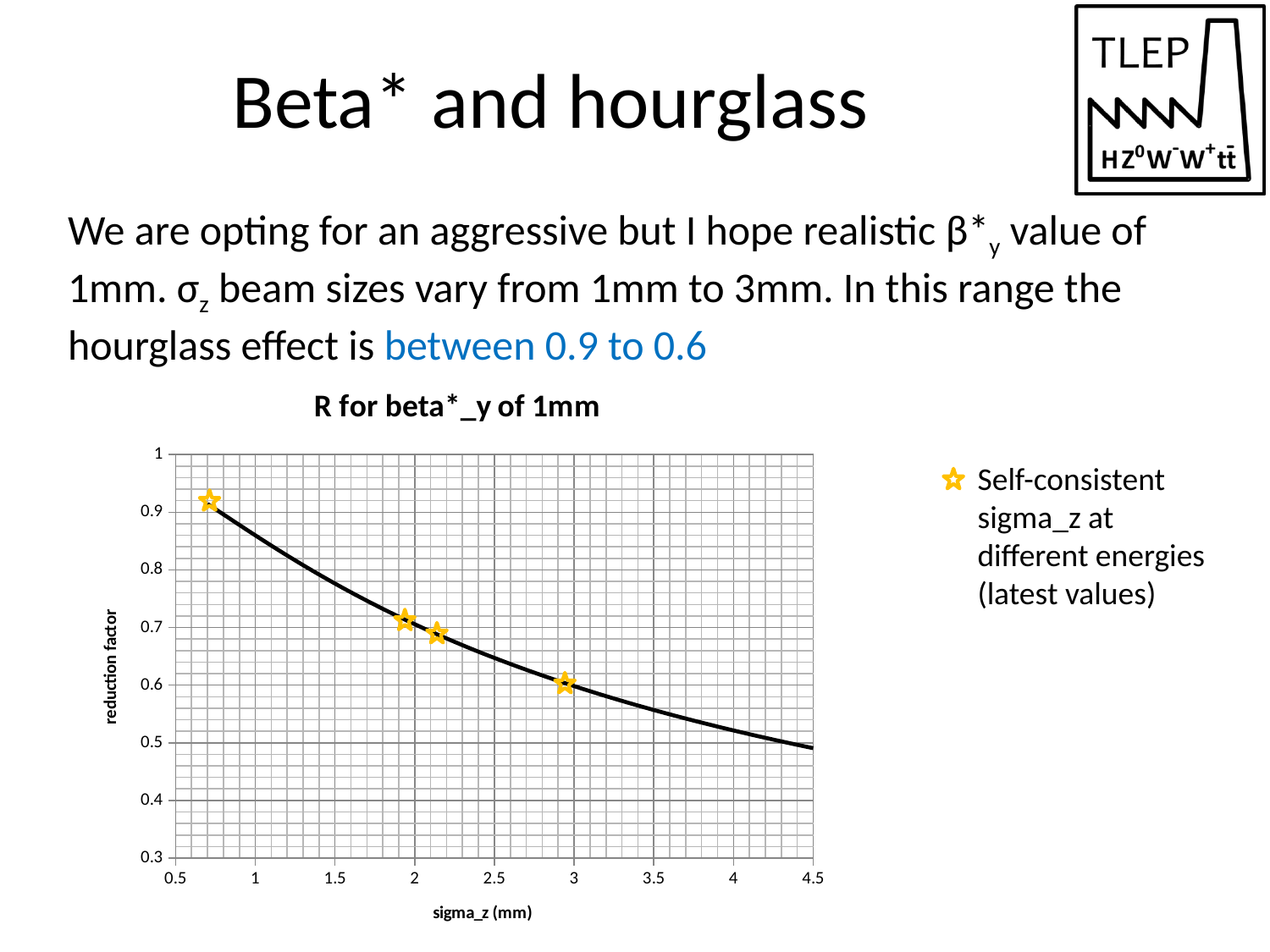
What is the title of the chart? R for beta*_y of 1mm How many star markers are plotted on the curve? 4 Is the reduction factor at sigma_z = 1 mm greater or less than 0.7? greater Is the reduction factor at sigma_z = 3 mm greater or less than 0.7? less What is the label of the x axis of the chart? sigma_z (mm) What kind of chart is shown on the slide? line chart What is the highest value shown on the x axis of the chart? 4.5 Does the reduction factor rise or fall as sigma_z increases? fall Which has the larger reduction factor, sigma_z = 1 mm or sigma_z = 3 mm? sigma_z = 1 mm Is the reduction factor at sigma_z = 2 mm greater or less than 0.8? less